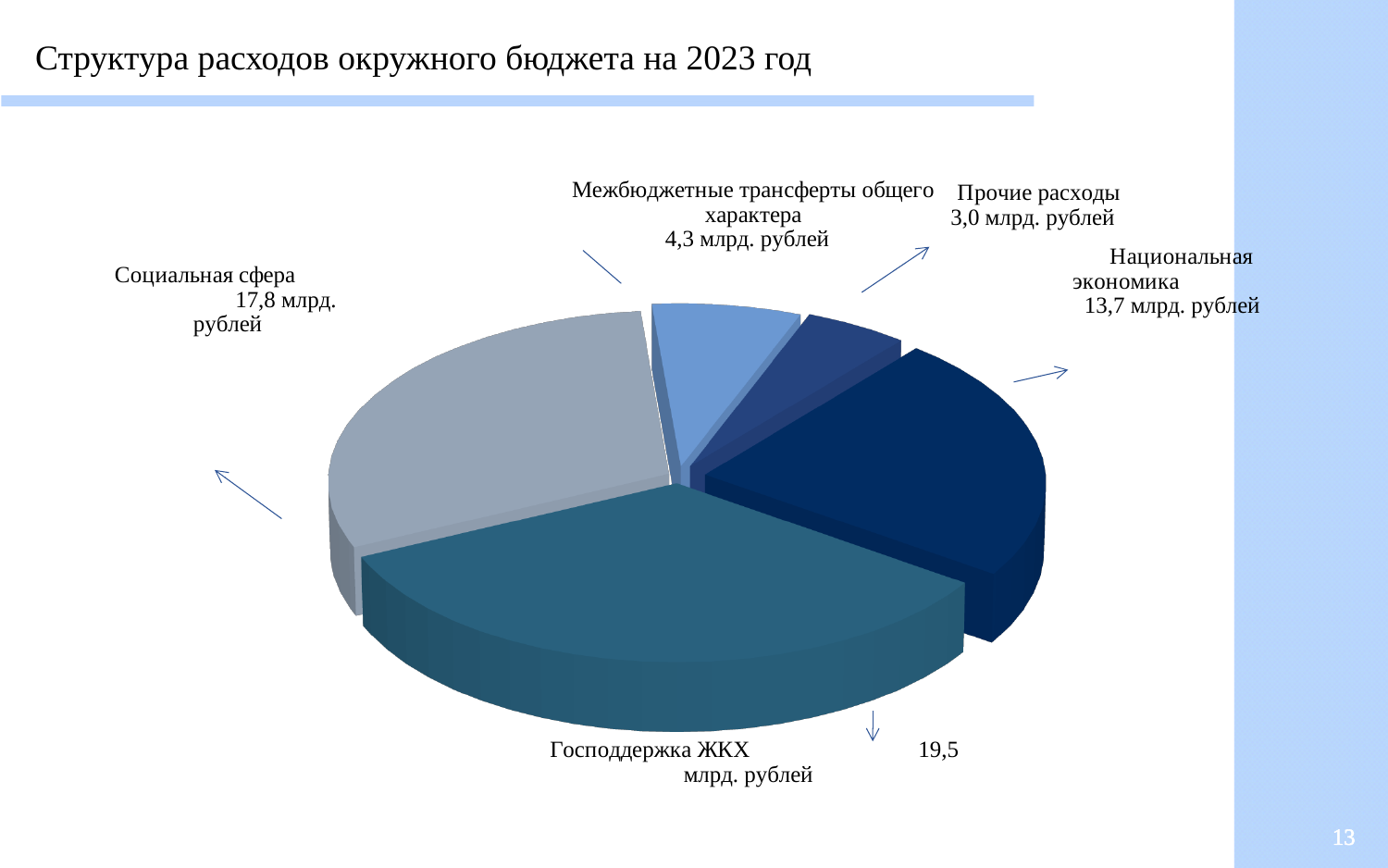
What is the value for Национальная экономика? 13,7 млрд. рублей Which category has the smallest share of the pie? Прочие расходы What is the value for Прочие расходы? 3,0 млрд. рублей What is the title of the chart on the slide? Структура расходов окружного бюджета на 2023 год What is the value for Госпoддержка ЖКХ? 19,5 млрд. рублей What is the value for Межбюджетные трансферты общего характера? 4,3 млрд. рублей What is the value for Социальная сфера? 17,8 млрд. рублей What is the difference between Госпoддержка ЖКХ and Социальная сфера? 1,7 млрд. рублей Which category has the largest share of the pie? Госпoддержка ЖКХ What kind of chart is shown on the slide? Pie chart How many slices does the pie chart have? 5 Which is larger, Социальная сфера or Национальная экономика? Социальная сфера